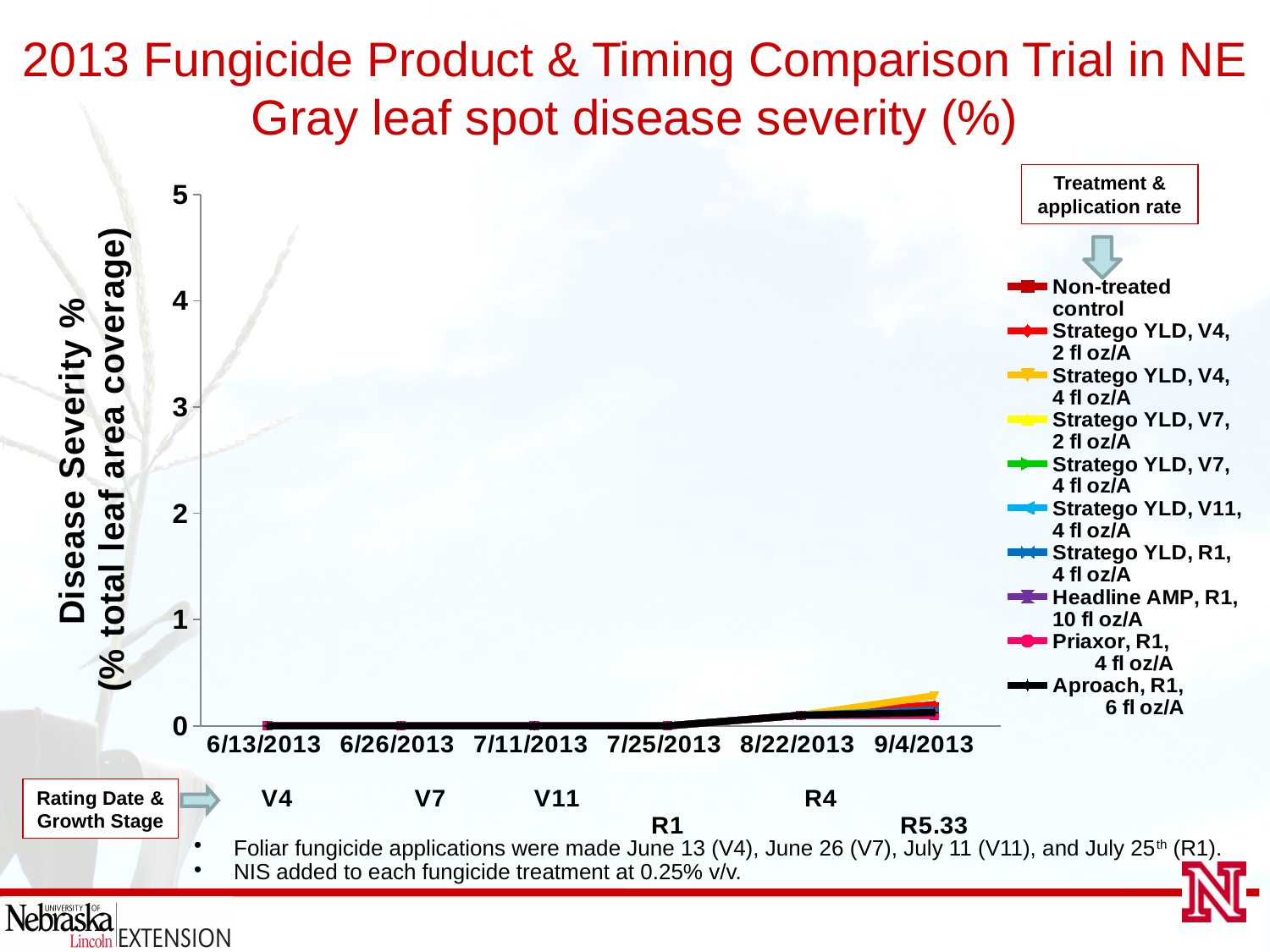
Is the disease severity value for Stratego YLD, V4, 4 fl oz/A on 9/4/2013 greater or less than 1? less How many treatments does the chart's legend list? 10 What is the first rating date shown on the x axis? 6/13/2013 What is the maximum value shown on the y axis of the chart? 5 Is the disease severity value for the Non-treated control on 9/4/2013 greater or less than 1? less How many rating dates are shown along the x axis of the chart? 6 Which treatment has the highest disease severity on 9/4/2013? Stratego YLD, V4, 4 fl oz/A What kind of chart is shown on the slide? line chart Is the disease severity value for Aproach, R1, 6 fl oz/A on 8/22/2013 greater or less than 1? less Do the disease severity values generally rise or fall from 6/13/2013 to 9/4/2013? rise